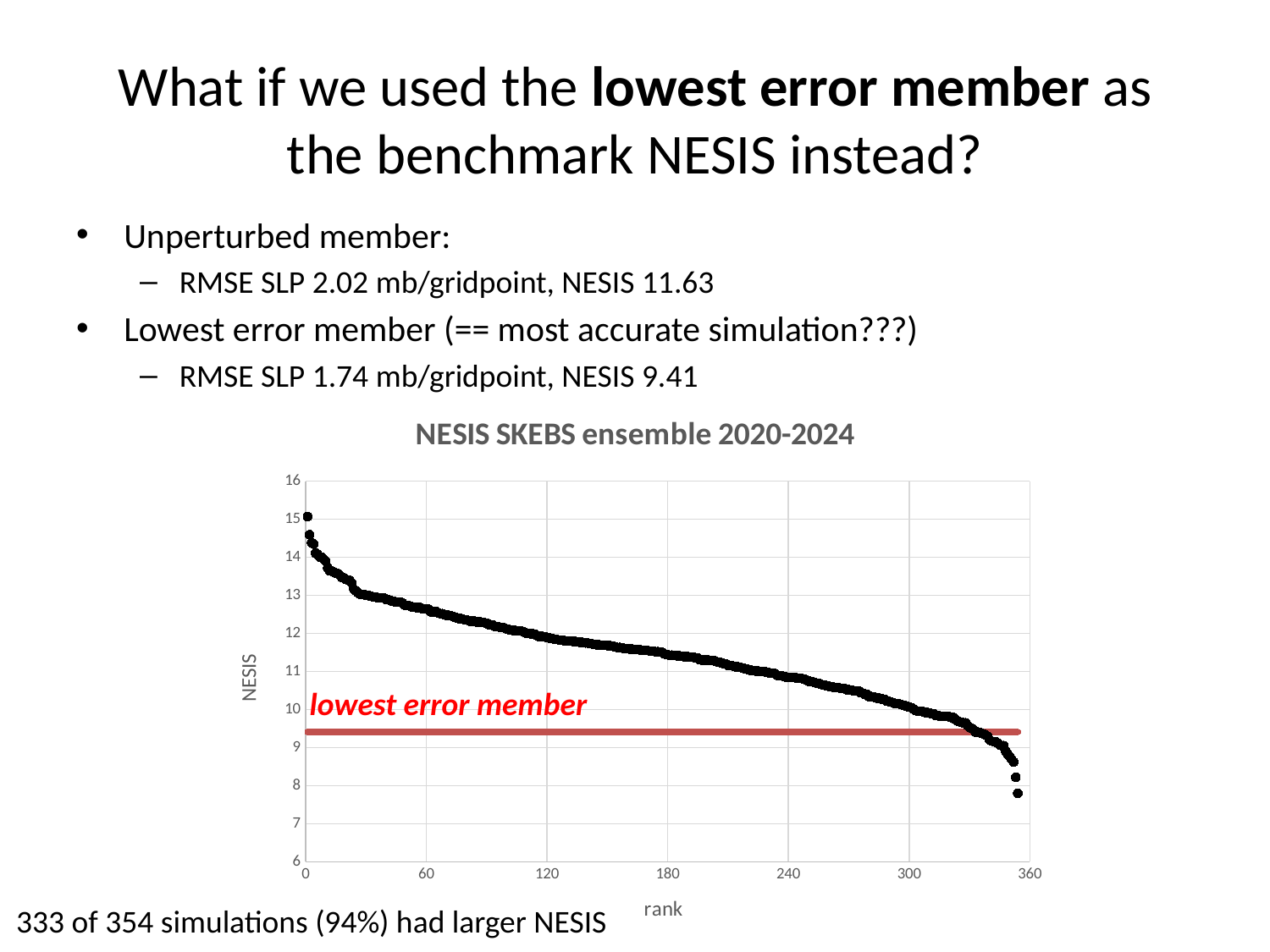
What is the maximum value shown on the NESIS (y) axis of the chart? 16 Is the red horizontal line marked 'lowest error member' above or below the NESIS value of 10 on the axis? below Is the NESIS value of the highest-ranked point (rank 1) greater or less than 14? greater Is the NESIS value at rank 60 greater or less than 13? less What kind of chart is shown on the slide? scatter chart Do the plotted NESIS values rise or fall as rank increases along the x axis? fall Which point has the higher NESIS value: the point at rank 60 or the point at rank 300? rank 60 What label is on the y axis of the chart? NESIS What is the title of the chart? NESIS SKEBS ensemble 2020-2024